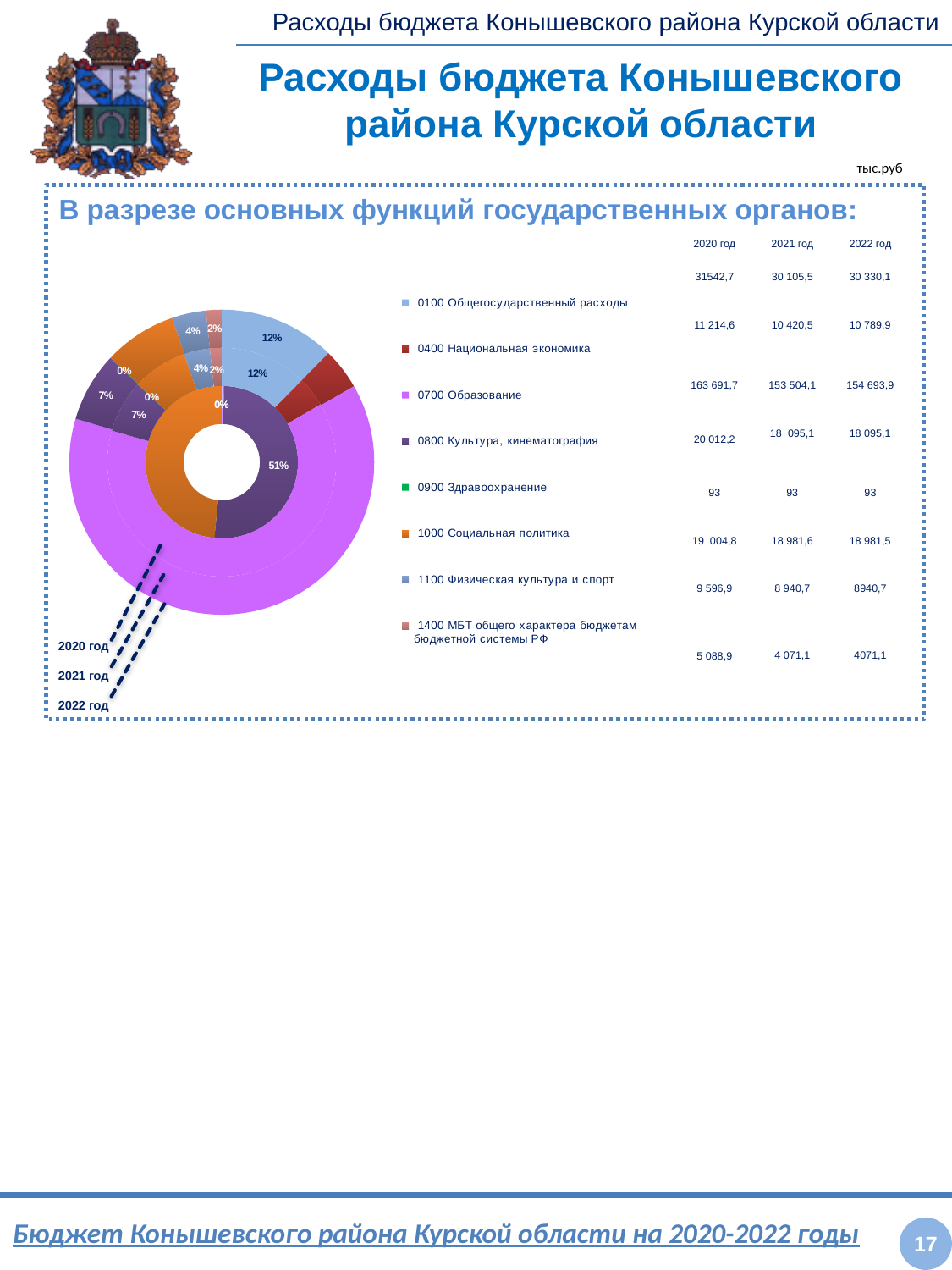
Which is larger in the chart: the share of 0700 Образование or the share of 0800 Культура, кинематография? 0700 Образование How many rings (years) does the doughnut chart have? 3 Which year does the outermost ring of the doughnut chart represent? 2022 год Which expenditure category has the smallest value in every year? 0900 Здравоохранение What unit of measurement is indicated for the values on the slide? тыс.руб What is the value for 0900 Здравоохранение in 2021 год? 93 What kind of chart is shown on the slide? Doughnut (pie) chart What is the value for 1400 МБТ общего характера бюджетам бюджетной системы РФ in 2020 год? 5 088,9 How many expenditure categories does the chart legend list? 8 Which expenditure category takes the largest share of the doughnut chart? 0700 Образование What is the value for 0100 Общегосударственный расходы in 2022 год? 30 330,1 What is the value for 0700 Образование in 2020 год? 163 691,7